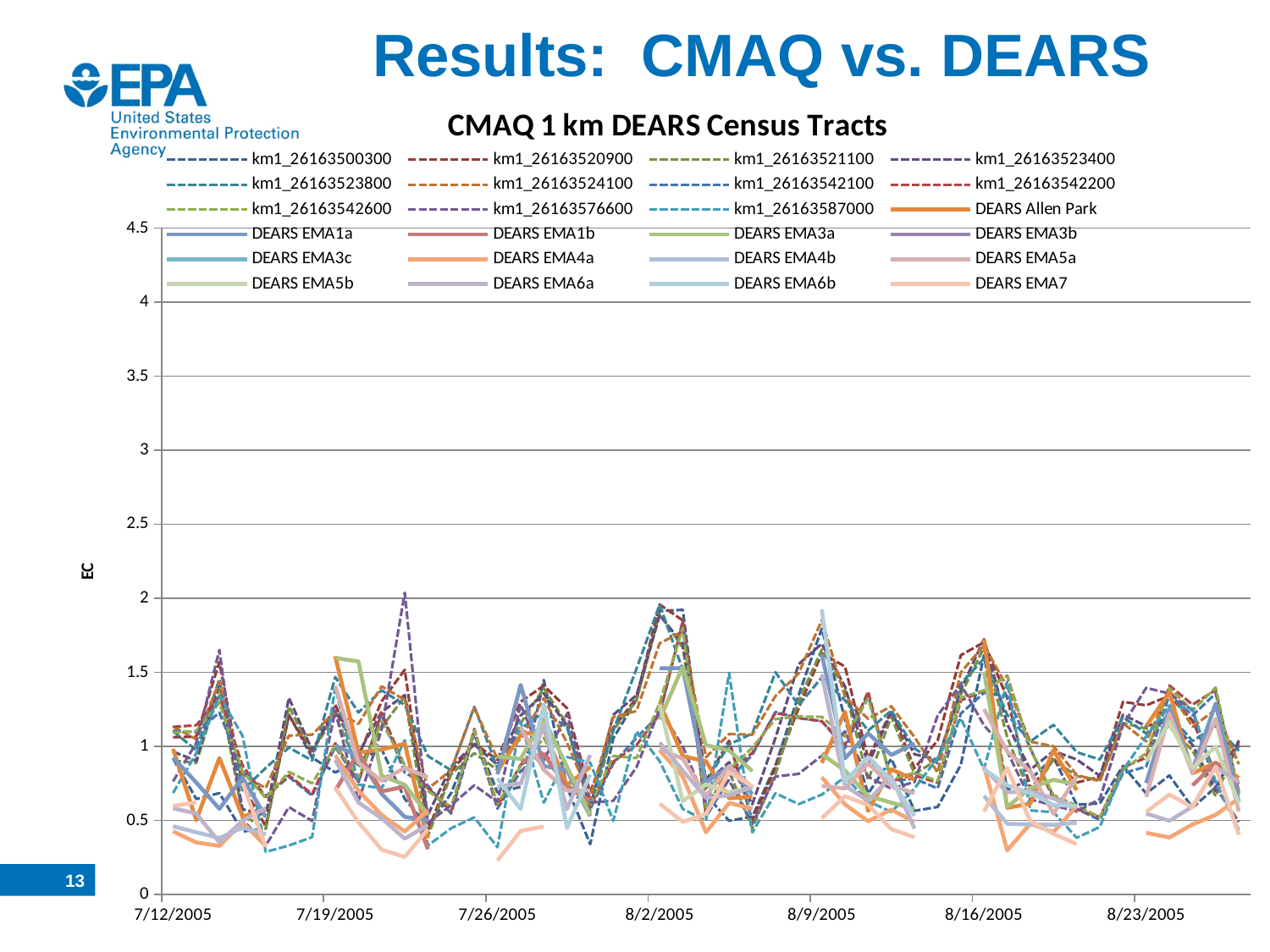
Is the lowest value plotted on the chart greater or less than 0.5? less What is the label on the y axis of the chart? EC What is the title of the chart? CMAQ 1 km DEARS Census Tracts Is the highest value plotted on the chart greater or less than 2.5? less Is the highest value plotted on the chart greater or less than 3? less How many series does the legend of the chart list? 24 What kind of chart is shown on the slide? line chart